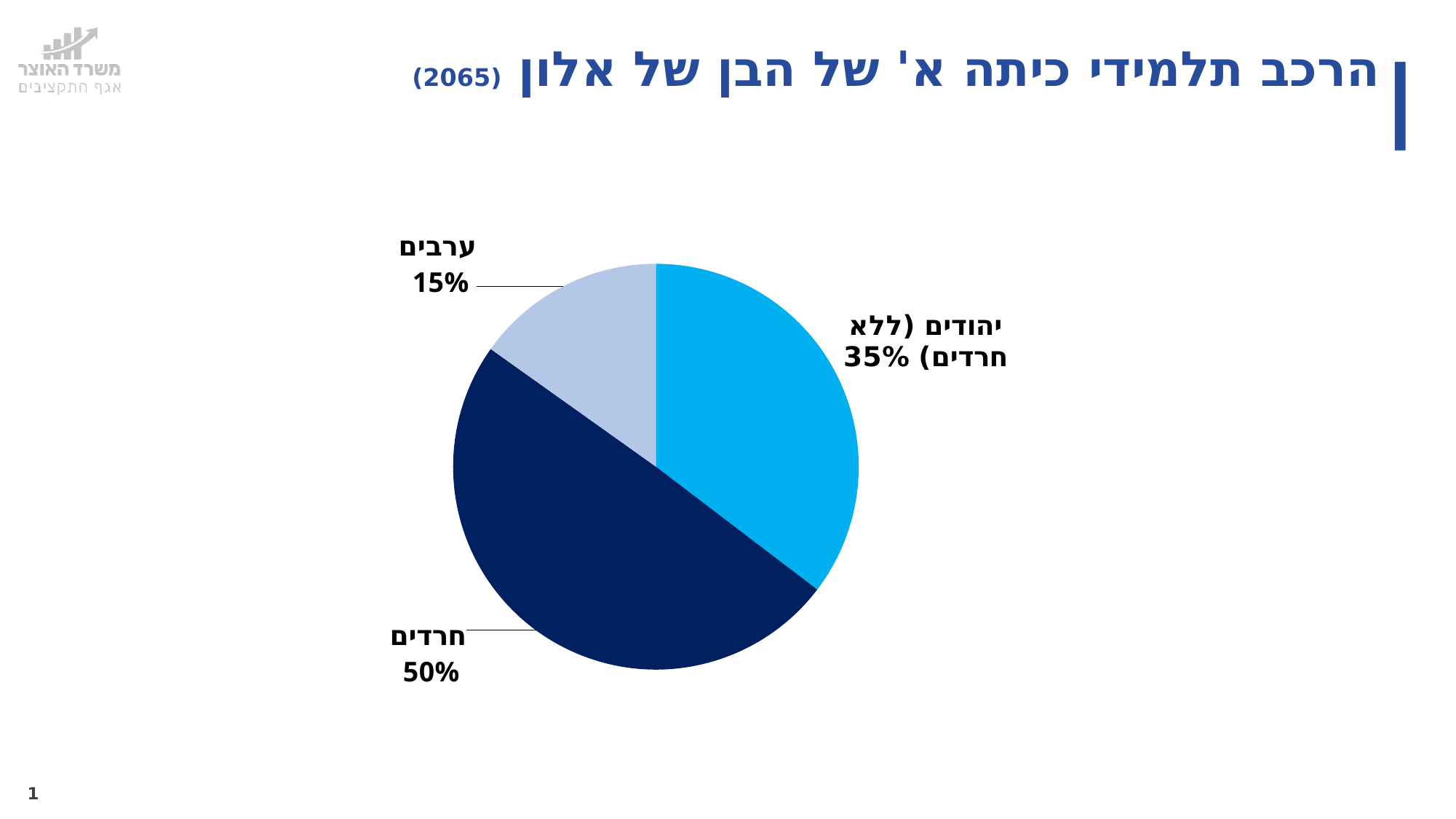
Which is larger, the יהודים (ללא חרדים) slice or the ערבים slice? יהודים (ללא חרדים) What share of the pie does the ערבים slice represent? 15% What share of the pie does the חרדים slice represent? 50% What is the difference in percentage points between the חרדים slice and the יהודים (ללא חרדים) slice? 15 Which category has the largest slice of the pie? חרדים What year is given in parentheses in the slide title? 2065 What is the difference in percentage points between the חרדים slice and the ערבים slice? 35 What kind of chart is shown on the slide? pie chart How many slices does the pie chart have? 3 What share of the pie does the יהודים (ללא חרדים) slice represent? 35% What colour is the חרדים slice of the pie? dark navy blue Which category has the smallest slice of the pie? ערבים